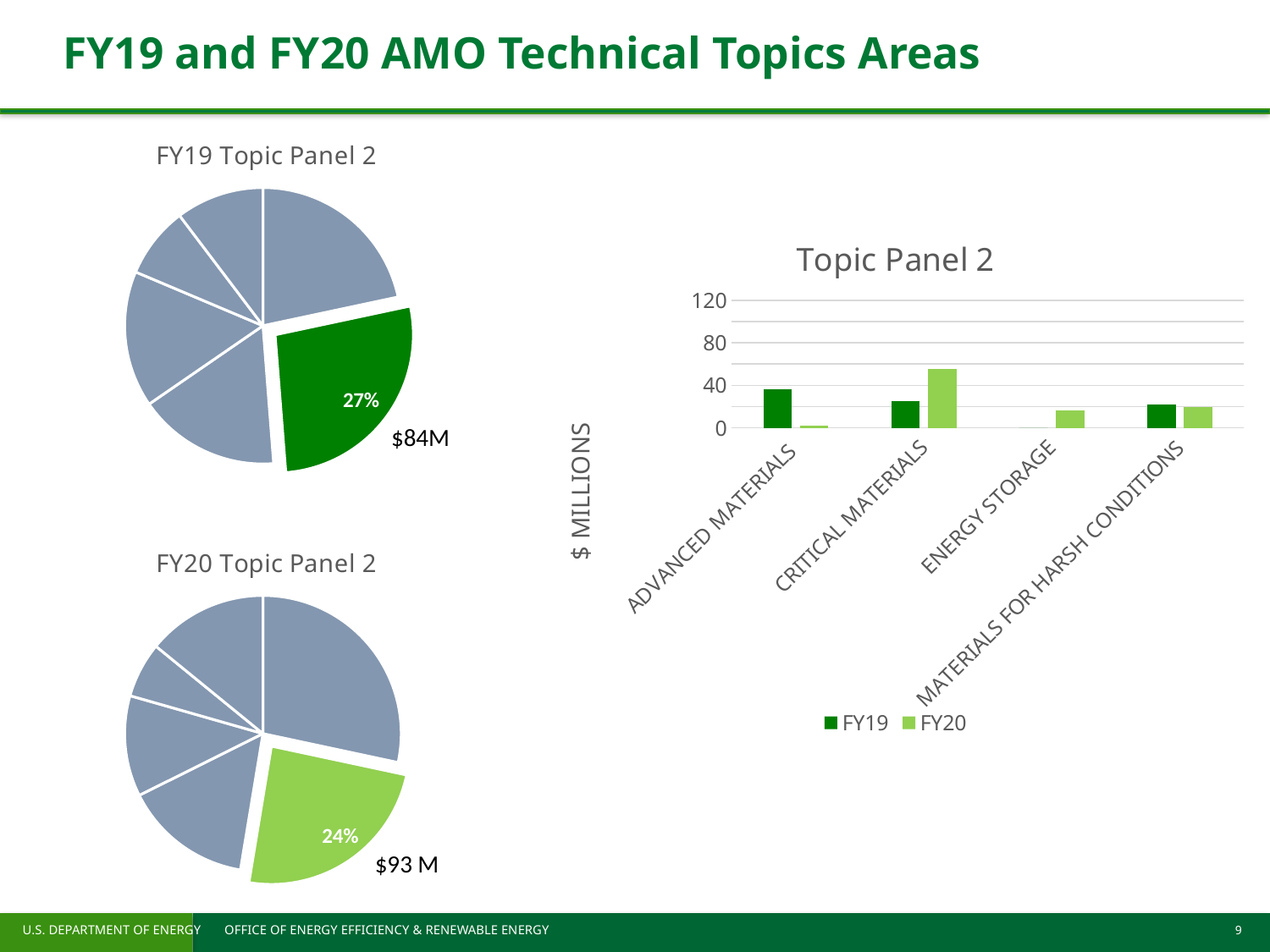
On the FY19 Topic Panel 2 pie chart, what dollar amount is printed next to the highlighted slice? $84M On the FY19 Topic Panel 2 pie chart, what percentage is shown on the highlighted green slice? 27% On the FY20 Topic Panel 2 pie chart, what percentage is shown on the highlighted green slice? 24% On the Topic Panel 2 bar chart, how many categories are shown on the x axis? 4 On the Topic Panel 2 bar chart, is the FY20 value for Critical Materials greater or less than 40? greater What kind of chart is the FY19 Topic Panel 2 chart on the left? Pie chart On the Topic Panel 2 bar chart, which category has the tallest bar overall? Critical Materials On the Topic Panel 2 bar chart, how many series does the legend list? 2 On the Topic Panel 2 bar chart, which is larger for Advanced Materials, FY19 or FY20? FY19 On the Topic Panel 2 bar chart, what is the label on the y axis? $ MILLIONS What kind of chart is the Topic Panel 2 chart on the right? Bar chart On the FY20 Topic Panel 2 pie chart, what dollar amount is printed next to the highlighted slice? $93 M